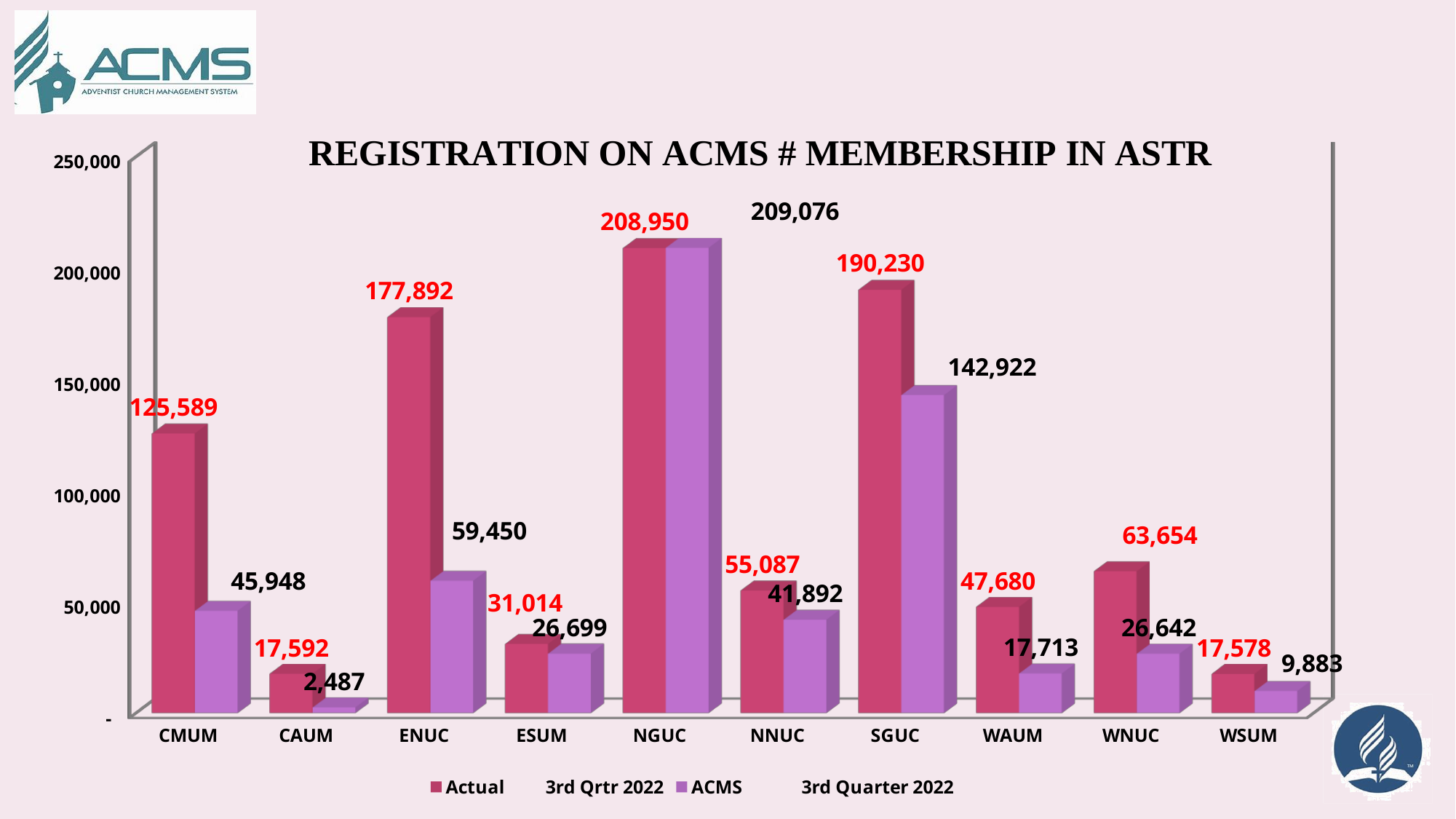
What is the difference between the Actual 3rd Qrtr 2022 and ACMS 3rd Quarter 2022 values for CMUM? 79,641 How many categories are shown on the x axis? 10 Which is larger, the Actual 3rd Qrtr 2022 value for ENUC or for SGUC? SGUC What is the ACMS 3rd Quarter 2022 value for WSUM? 9,883 Which category has the highest Actual 3rd Qrtr 2022 value? NGUC What type of chart is shown on the slide? bar chart How many series does the legend list? 2 What is the ACMS 3rd Quarter 2022 value for SGUC? 142,922 Is the Actual 3rd Qrtr 2022 value for WNUC greater or less than 50,000? greater What is the title of the chart? REGISTRATION ON ACMS # MEMBERSHIP IN ASTR Which category has the lowest ACMS 3rd Quarter 2022 value? CAUM What is the Actual 3rd Qrtr 2022 value for CMUM? 125,589